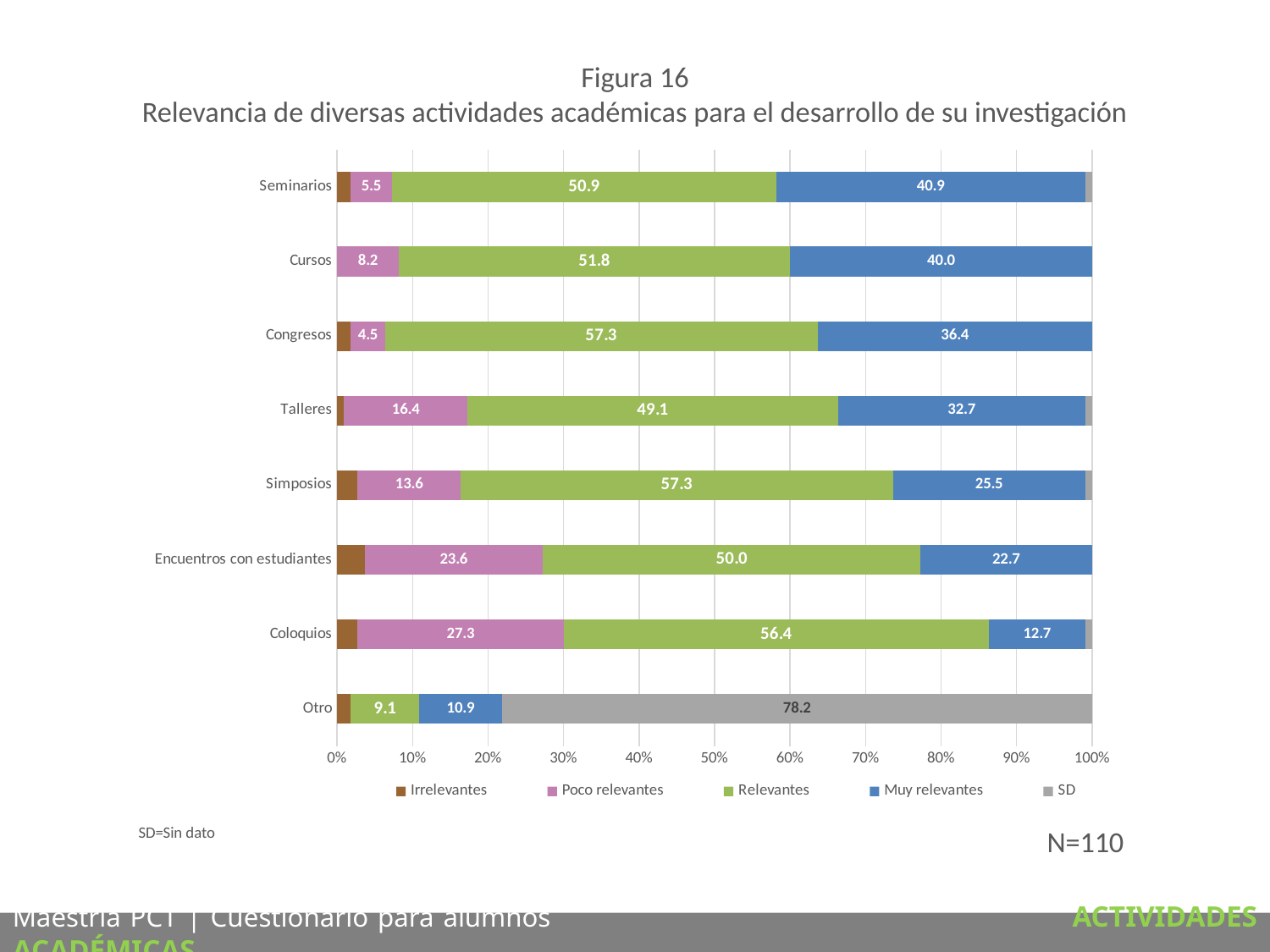
What is the 'Relevantes' value for Congresos? 57.3 Which is larger: the 'Relevantes' value for Cursos or for Seminarios? Cursos Is the 'Irrelevantes' value for Encuentros con estudiantes greater or less than 10%? less What is the 'SD' value for Otro? 78.2 What is the difference between the 'Muy relevantes' values for Cursos and Coloquios? 27.3 How many academic activities (categories) are shown on the chart? 8 Which activity has the highest 'Poco relevantes' value? Coloquios How many series does the legend list? 5 What is the 'Muy relevantes' value for Talleres? 32.7 What type of chart is shown on the slide? Stacked bar chart Which activity has the highest 'Muy relevantes' value? Seminarios What is the 'Poco relevantes' value for Encuentros con estudiantes? 23.6